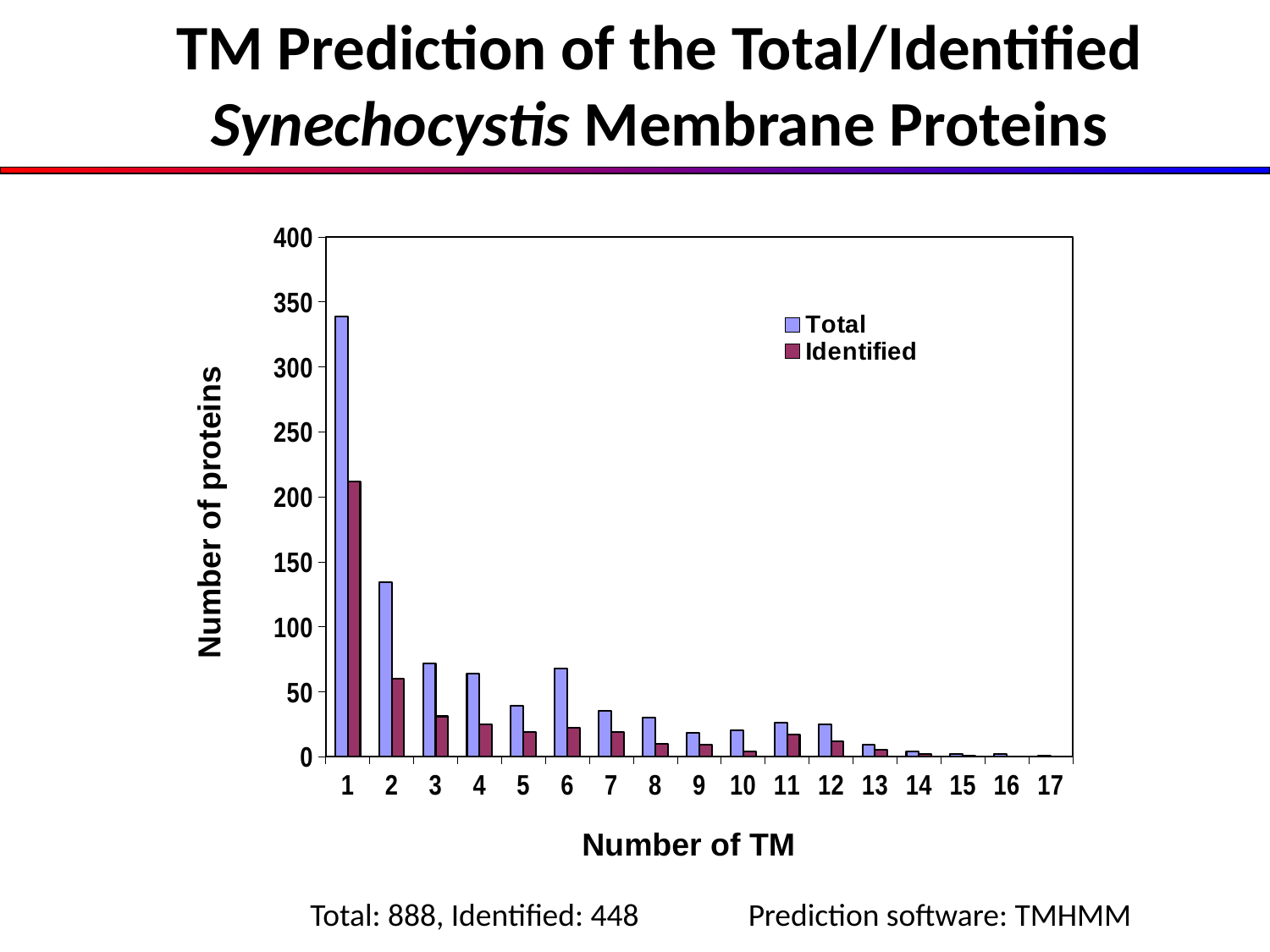
What is the title of the x axis? Number of TM How many series does the legend list? 2 Is the Total value at Number of TM 2 greater or less than 100? greater Which is larger, the Total value at Number of TM 5 or at Number of TM 6? 6 Is the Identified value at Number of TM 1 greater or less than 250? less Which is larger, the Total value at Number of TM 2 or at Number of TM 3? 2 What kind of chart is shown on the slide? bar chart Is the Total value at Number of TM 1 greater or less than 300? greater How many Number of TM categories are shown on the x axis? 17 At which Number of TM is the Total series highest? 1 Overall, do the Total values rise or fall as the Number of TM increases? fall